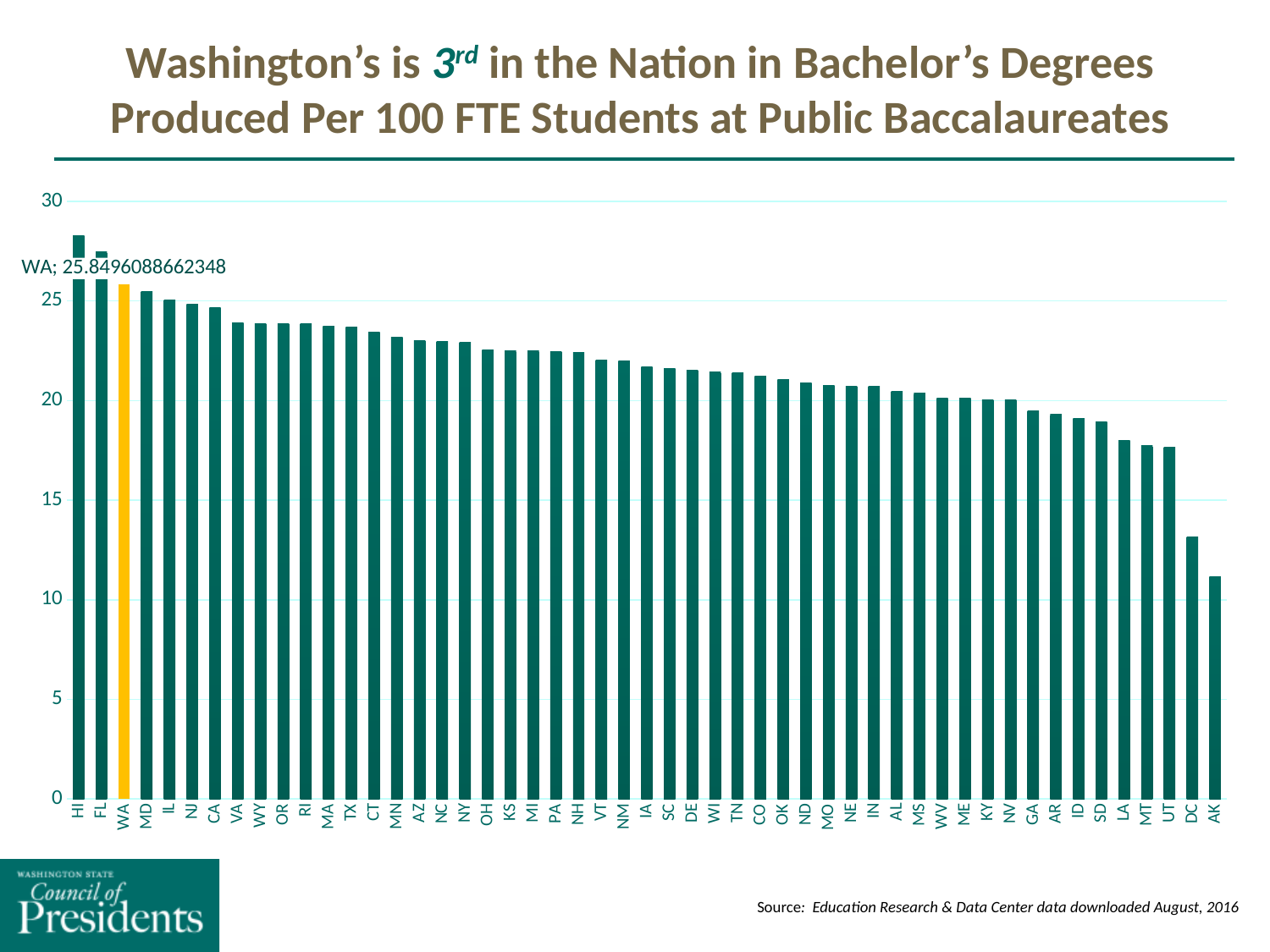
Is the value for DC greater or less than 15? less Which state has the highest bar? HI Which is larger, the value for FL or the value for MT? FL How many states or jurisdictions are shown on the x axis? 51 Do the bar values rise or fall moving from left to right along the x axis? fall Which bar is highlighted in a different colour (yellow) from the rest? WA Which state has the lowest bar? AK What kind of chart is shown on the slide? bar chart Is the value for UT greater or less than 20? less What value is printed for WA? 25.8496088662348 Is the value for HI greater or less than 25? greater